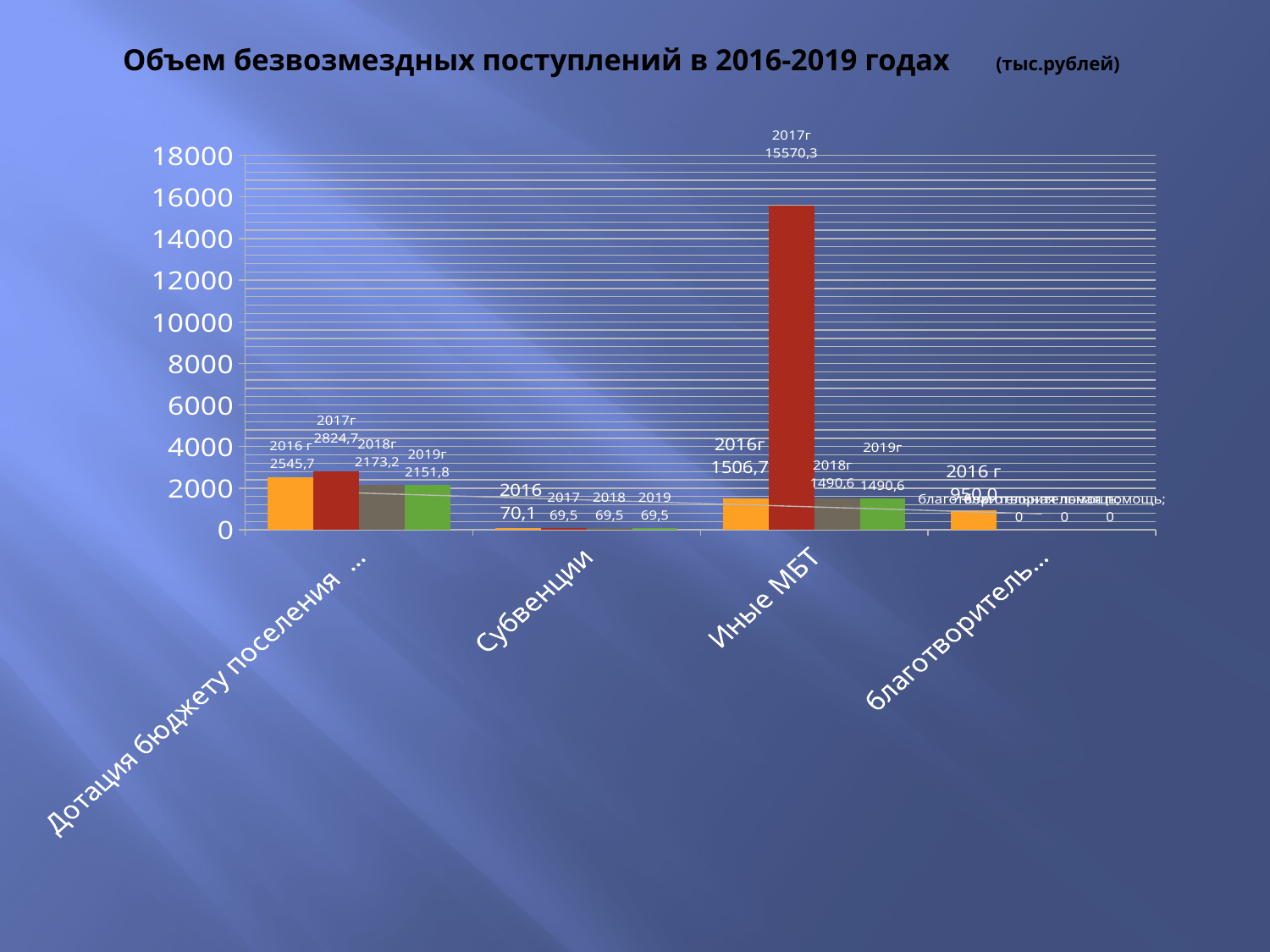
What is the difference between the 2017 and 2016 values for Дотация бюджету поселения? 279,0 What is the value for благотворительная помощь in 2016? 950,0 What is the value for Иные МБТ in 2017? 15570,3 Which category has the tallest bar on the chart? Иные МБТ Is the 2017 value for Иные МБТ greater or less than 14000? greater What is the value for Иные МБТ in 2019? 1490,6 How many categories are shown on the x axis? 4 What is the value for Субвенции in 2016? 70,1 What is the value for Дотация бюджету поселения in 2016? 2545,7 Which is larger: the 2016 value for Иные МБТ or the 2016 value for благотворительная помощь? Иные МБТ What kind of chart is shown on the slide? bar chart Which year has the highest value for Дотация бюджету поселения? 2017